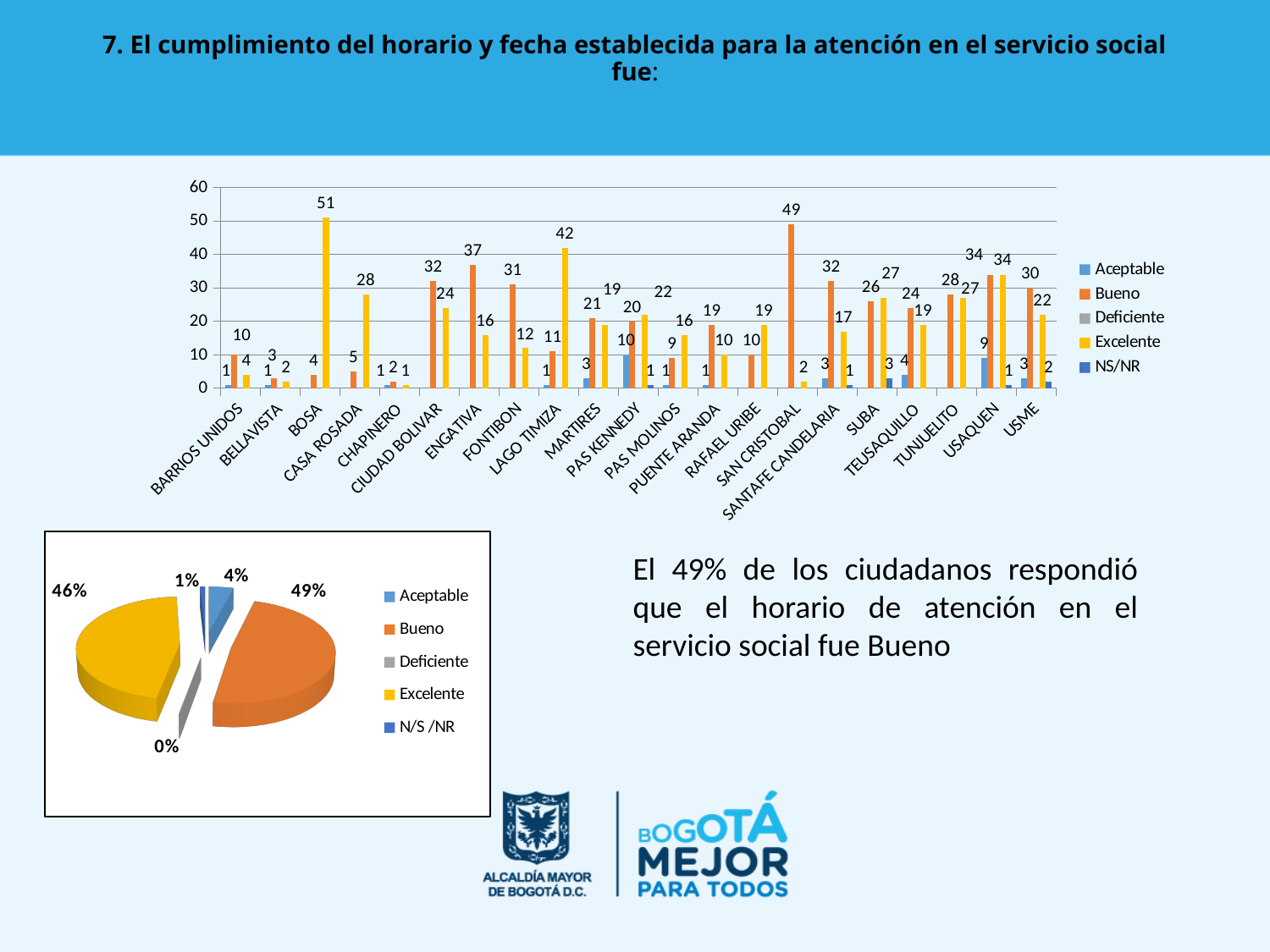
In the bar chart, which category has the highest Excelente value? BOSA In the bar chart, which is larger for FONTIBON: the Bueno value or the Excelente value? Bueno In the pie chart, which slice is the smallest? Deficiente What kind of chart is the chart at the bottom left of the slide? Pie chart How many categories are shown on the x axis of the bar chart? 21 In the bar chart, what is the Excelente value for LAGO TIMIZA? 42 How many series does the legend of the bar chart list? 5 In the bar chart, what is the Bueno value for SAN CRISTOBAL? 49 In the pie chart, what share does Bueno have? 49% In the bar chart, what is the Excelente value for BOSA? 51 In the bar chart, what is the difference between the Bueno and Excelente values for CIUDAD BOLIVAR? 8 In the pie chart, what share does Excelente have? 46%